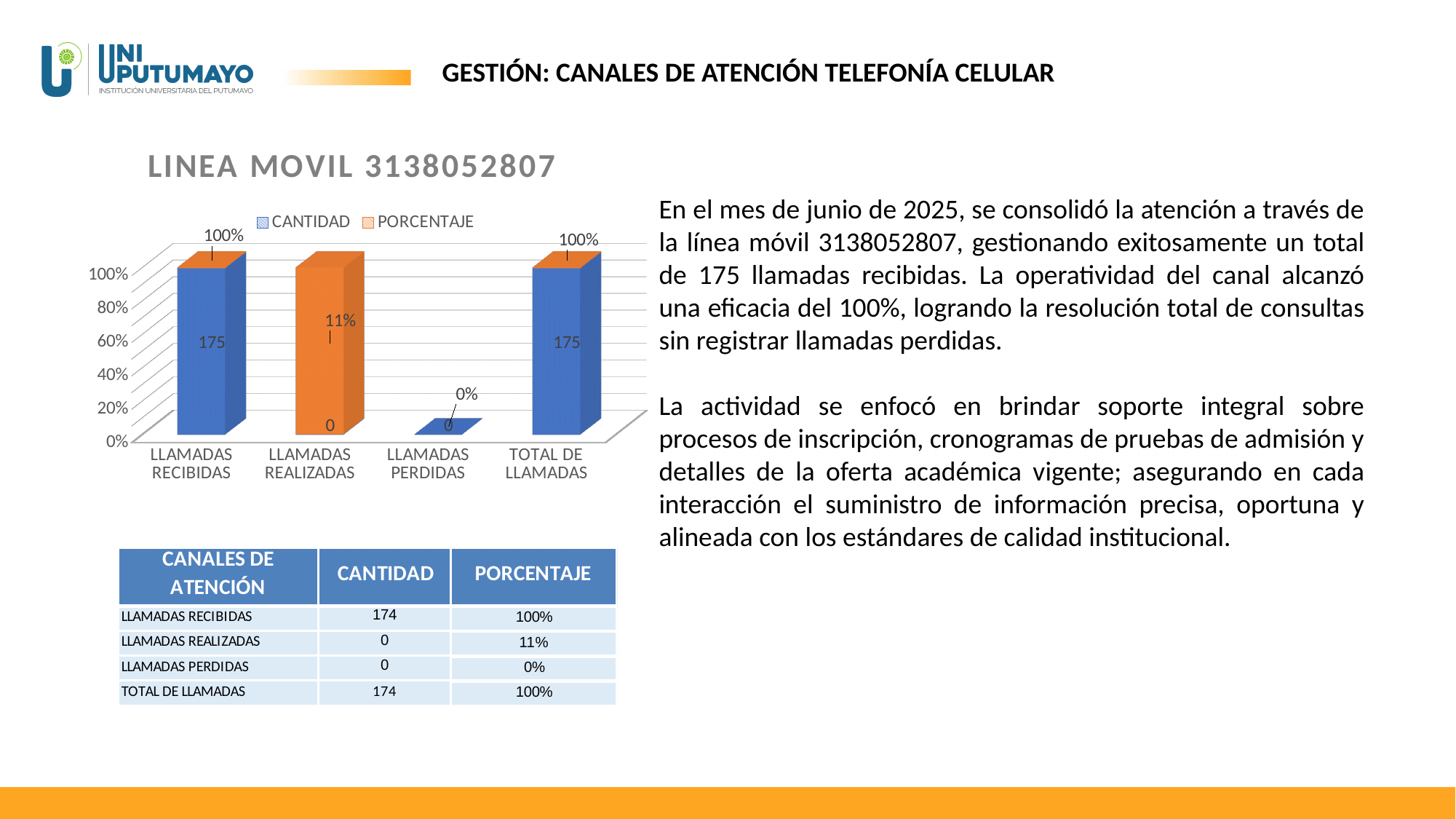
What is the CANTIDAD value for TOTAL DE LLAMADAS in the chart? 175 What is the title of the chart? LINEA MOVIL 3138052807 What is the PORCENTAJE value for LLAMADAS REALIZADAS in the chart? 11% How many categories are shown on the x axis of the chart? 4 What is the difference between the CANTIDAD values for LLAMADAS RECIBIDAS and LLAMADAS PERDIDAS in the chart? 175 What is the PORCENTAJE value for LLAMADAS PERDIDAS in the chart? 0% What type of chart is shown on the slide? bar chart Which has the larger CANTIDAD value in the chart, LLAMADAS RECIBIDAS or LLAMADAS REALIZADAS? LLAMADAS RECIBIDAS How many series does the chart legend list? 2 Which series are listed in the chart legend? CANTIDAD and PORCENTAJE What is the CANTIDAD value for LLAMADAS PERDIDAS in the chart? 0 What is the CANTIDAD value for LLAMADAS RECIBIDAS in the chart? 175